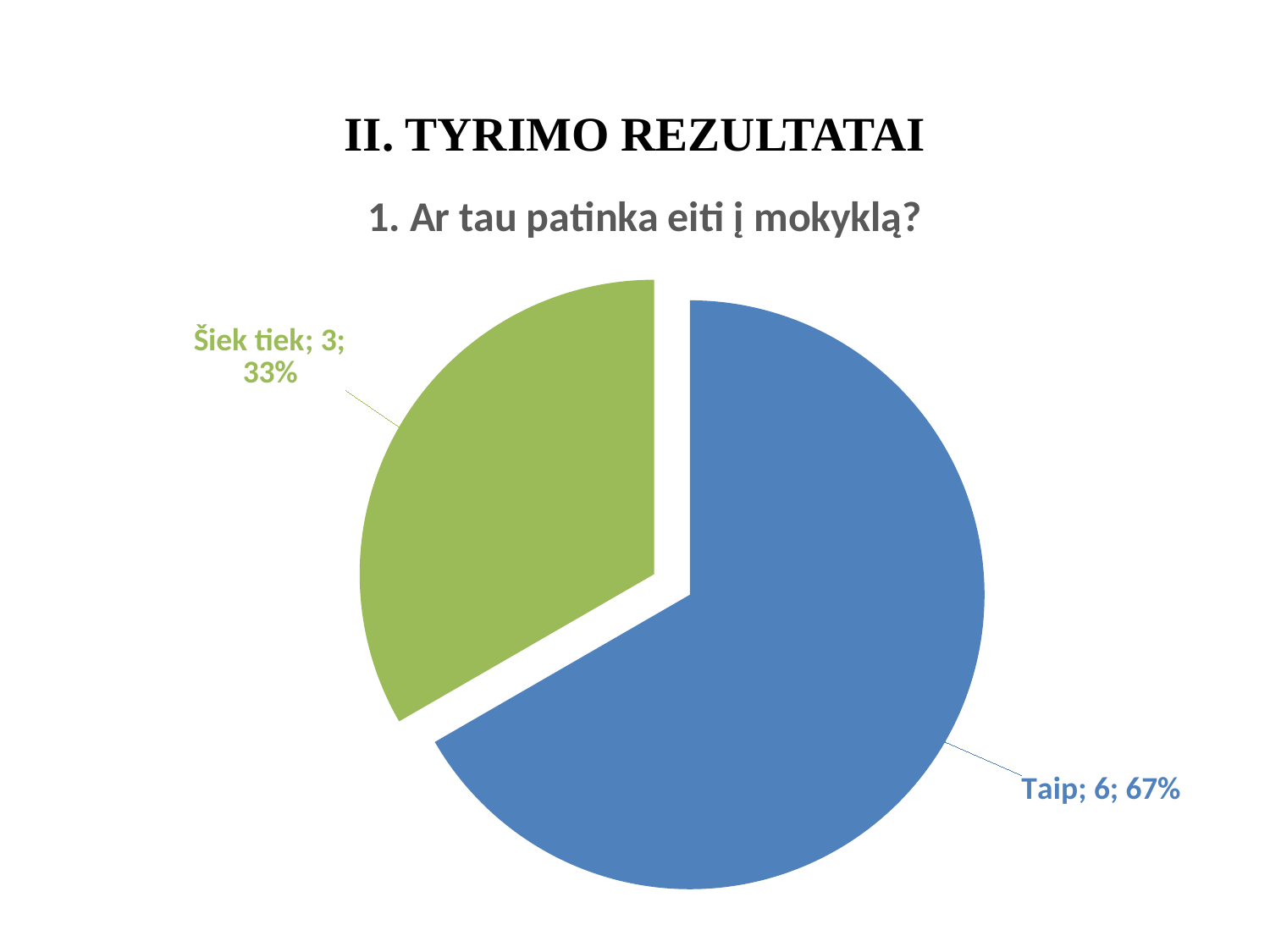
Which slice is the largest? Taip What is the count for the "Taip" slice? 6 How many slices does the pie chart have? 2 What is the count for the "Šiek tiek" slice? 3 Which slice is the smallest? Šiek tiek What is the difference between the counts for "Taip" and "Šiek tiek"? 3 What colour is the "Šiek tiek" slice? green What share of the pie does the "Šiek tiek" slice represent? 33% Which is larger, the "Taip" slice or the "Šiek tiek" slice? Taip What kind of chart is shown on the slide? pie chart What share of the pie does the "Taip" slice represent? 67% What is the title of the chart? 1. Ar tau patinka eiti į mokyklą?